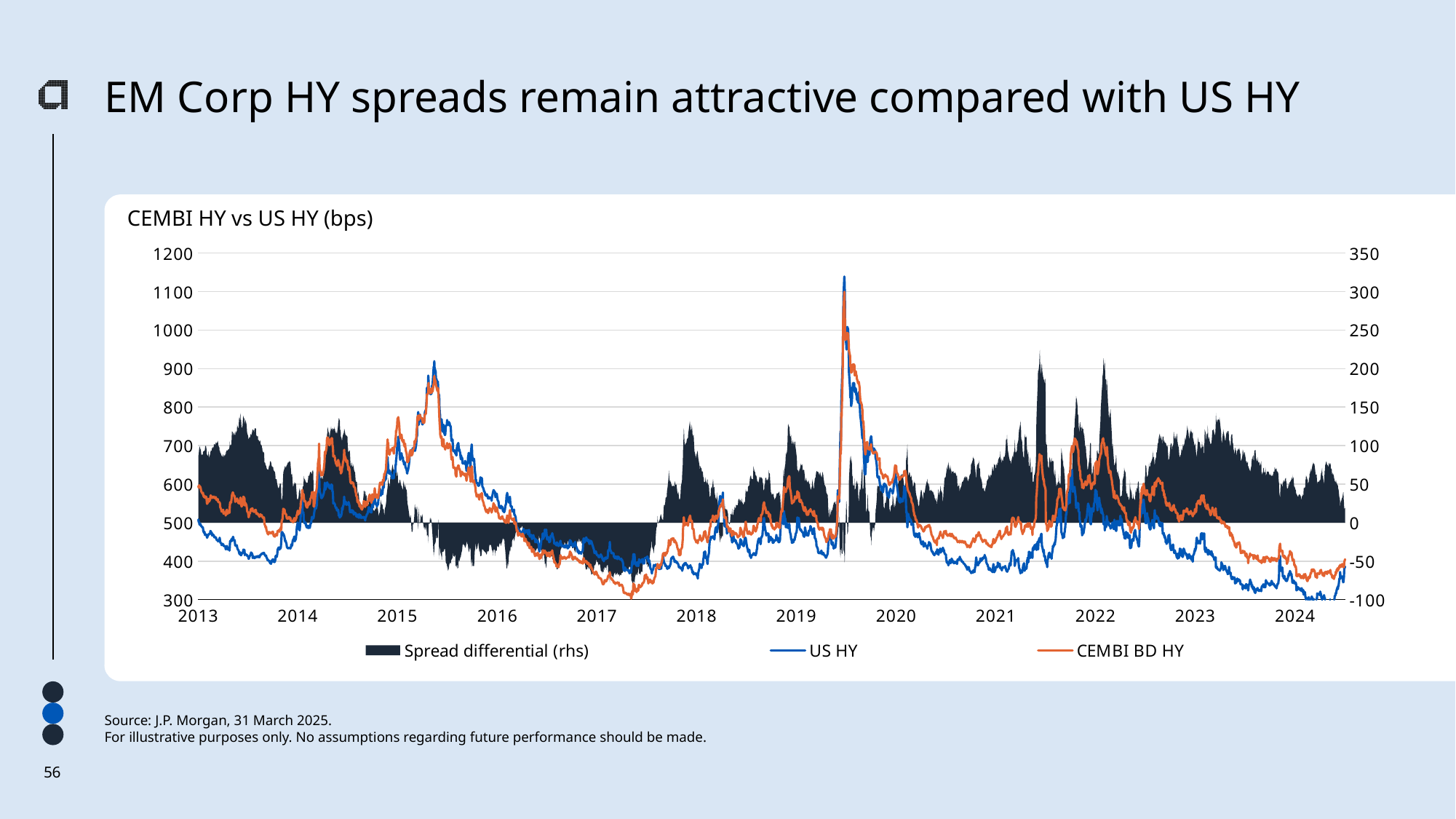
Is the value of US HY at the end of 2024 greater or less than 400? less Is the value of CEMBI BD HY at the start of 2013 greater or less than 500? greater Does the US HY series rise or fall from 2022 to the end of 2024? fall At the end of 2024, which is higher, US HY or CEMBI BD HY? CEMBI BD HY Is the peak value of US HY in 2020 greater or less than 1000? greater What is the title of the chart? CEMBI HY vs US HY (bps) How many series does the legend list? 3 What kind of chart is shown on the slide? line chart How many year labels are shown on the x axis? 12 Which axis does the Spread differential series use? right-hand axis